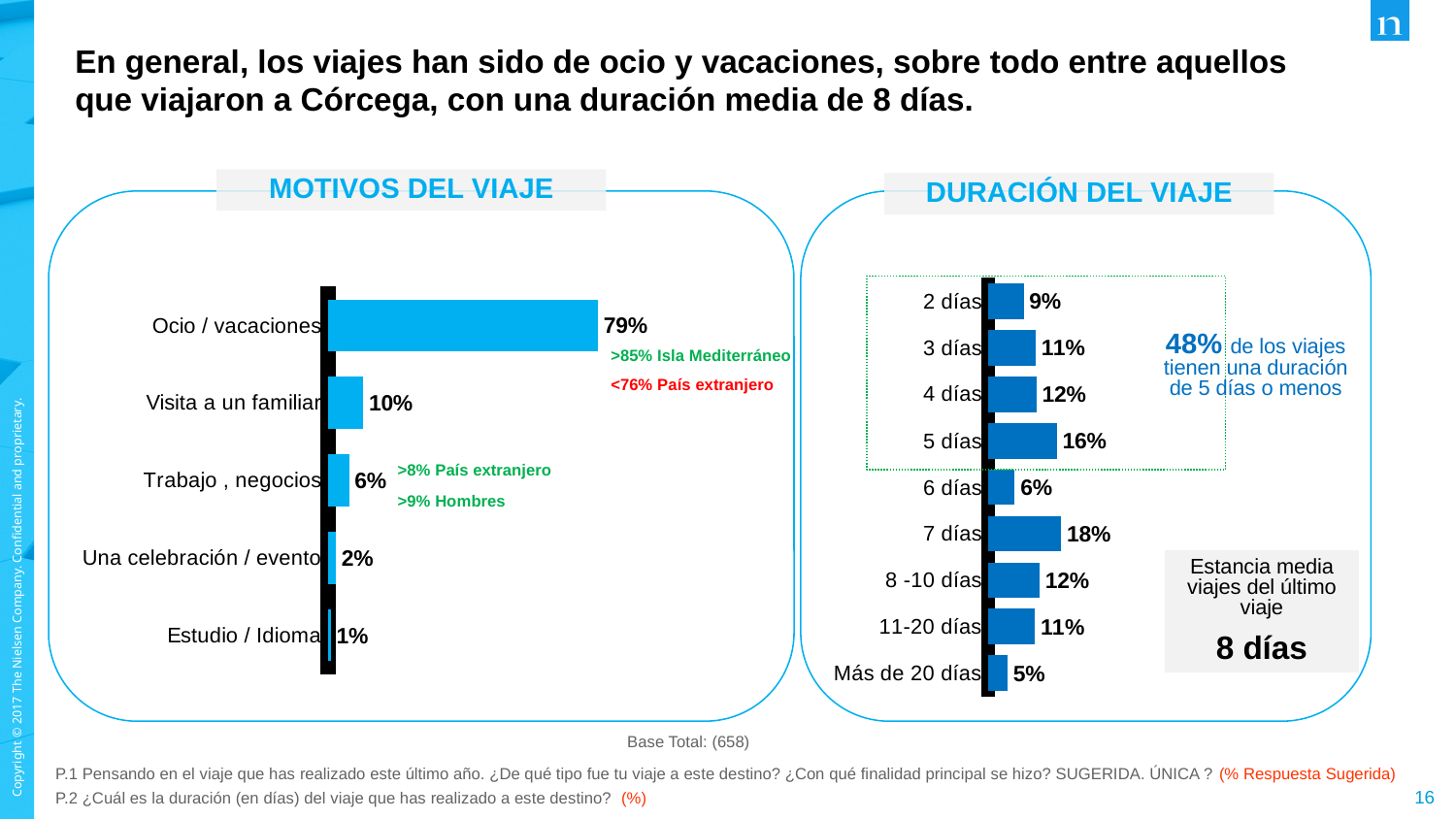
In the DURACIÓN DEL VIAJE chart, what is the value for 7 días? 18% In the MOTIVOS DEL VIAJE chart, what is the value for Trabajo , negocios? 6% In the MOTIVOS DEL VIAJE chart, what is the value for Ocio / vacaciones? 79% What type of chart is the DURACIÓN DEL VIAJE chart? Bar chart In the DURACIÓN DEL VIAJE chart, what is the difference between 5 días and 2 días? 7% In the DURACIÓN DEL VIAJE chart, which category has the highest value? 7 días In the DURACIÓN DEL VIAJE chart, which is larger, 5 días or 6 días? 5 días In the DURACIÓN DEL VIAJE chart, what is the value for Más de 20 días? 5% In the MOTIVOS DEL VIAJE chart, how many categories are shown? 5 In the MOTIVOS DEL VIAJE chart, what is the difference between Ocio / vacaciones and Visita a un familiar? 69% In the MOTIVOS DEL VIAJE chart, which category has the lowest value? Estudio / Idioma In the DURACIÓN DEL VIAJE chart, how many categories are shown? 9